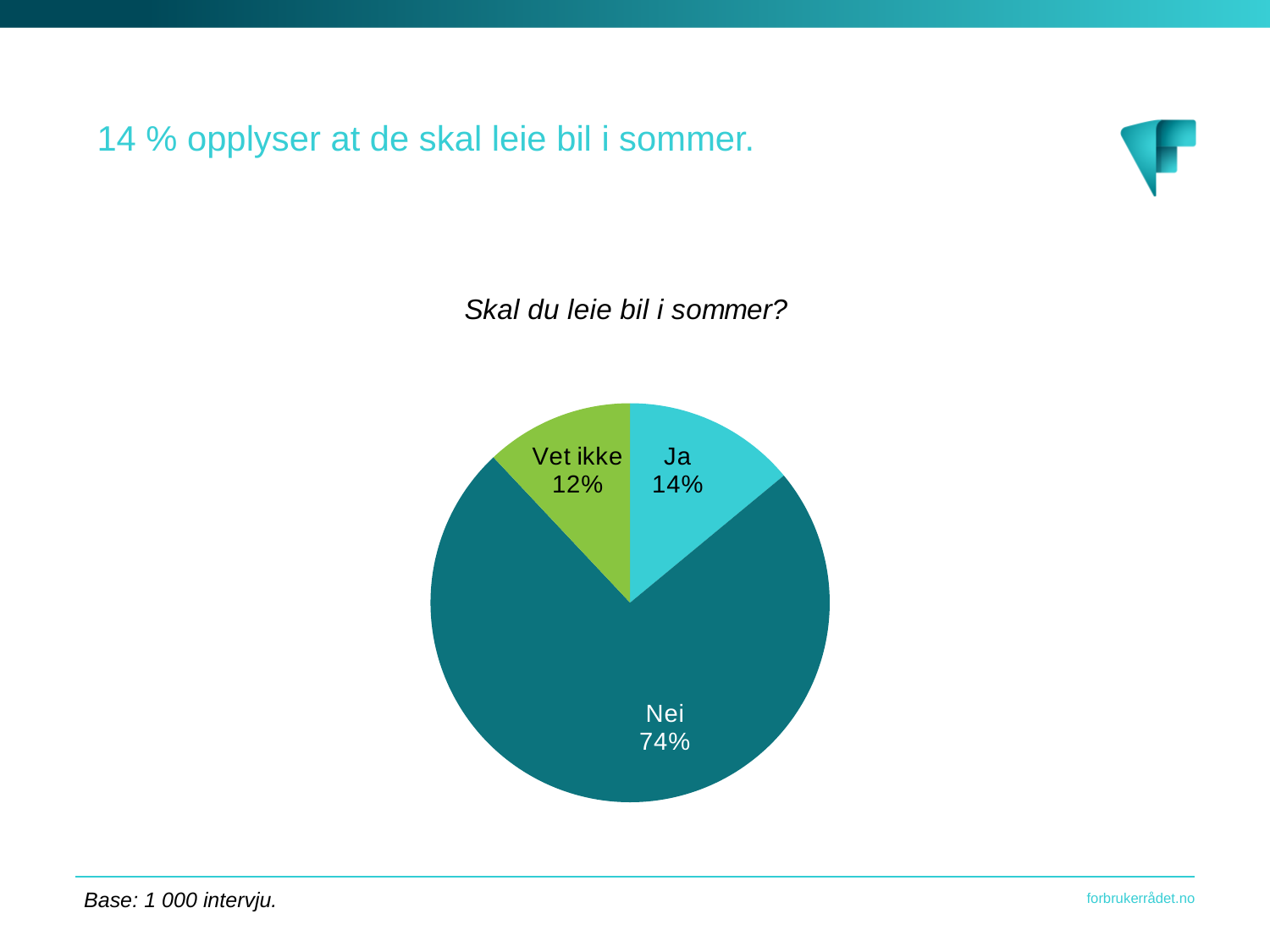
What is the value for "Ja" in the pie chart? 14% How many slices does the pie chart have? 3 Which category has the largest slice in the pie chart? Nei What is the difference between the values for "Nei" and "Ja"? 60% What kind of chart is shown on the slide? pie chart Which category has the smallest slice in the pie chart? Vet ikke Which is larger, the slice for "Nei" or the slice for "Ja"? Nei What is the title of the pie chart? Skal du leie bil i sommer? What is the difference between the values for "Ja" and "Vet ikke"? 2% What is the value for "Vet ikke" in the pie chart? 12% What is the value for "Nei" in the pie chart? 74% What colour is the "Vet ikke" slice in the pie chart? green